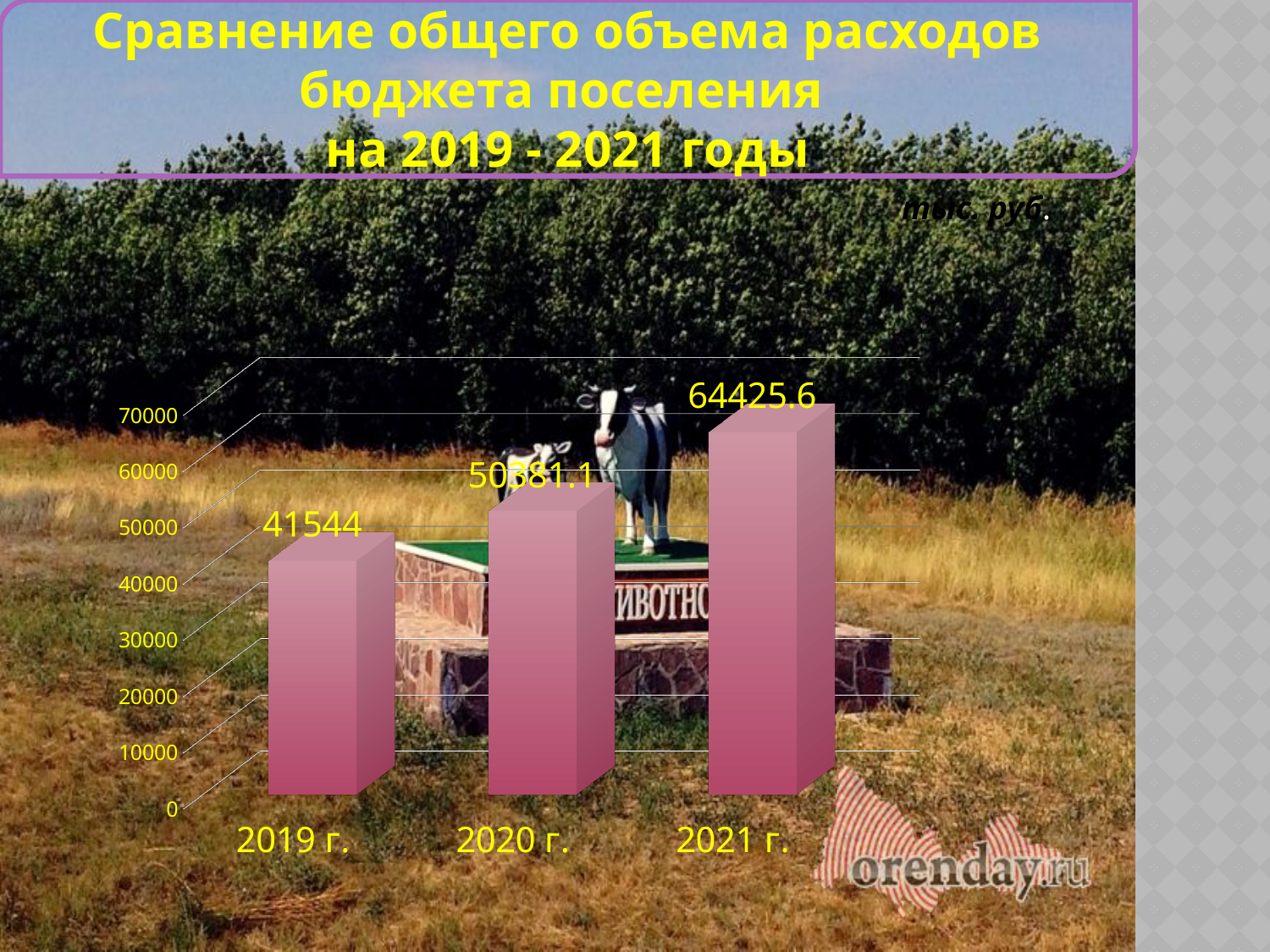
Which year has the highest value? 2021 г. Which is larger, the value for 2020 г. or the value for 2019 г.? 2020 г. What is the difference between the values for 2021 г. and 2019 г.? 22881.6 Do the values rise or fall from 2019 г. to 2021 г.? rise What kind of chart is shown on the slide? bar chart Which year has the lowest value? 2019 г. Is the value for 2020 г. greater or less than 40000? greater What is the value for 2019 г.? 41544 How many years are shown on the chart? 3 Is the value for 2021 г. greater or less than 60000? greater Is the value for 2019 г. greater or less than 50000? less What is the value for 2021 г.? 64425.6